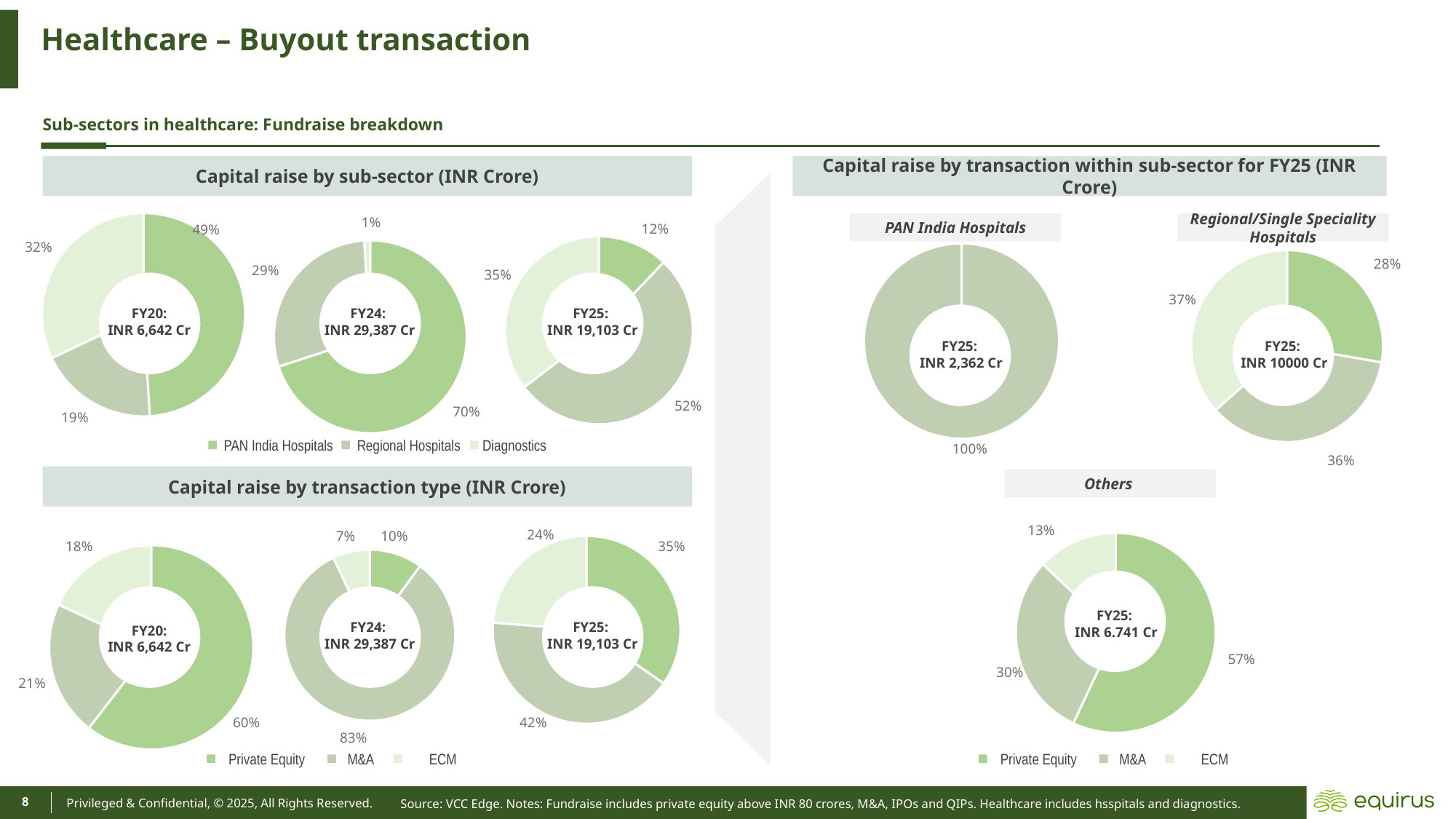
In the 'Capital raise by transaction type (INR Crore)' chart, what is the difference between the Private Equity share and the ECM share in FY20? 42% In the 'Capital raise by transaction within sub-sector for FY25 (INR Crore)' chart, what is the FY25 capital raise for Regional/Single Speciality Hospitals? INR 10000 Cr In the 'Capital raise by sub-sector (INR Crore)' chart, what is the total capital raise shown for FY24? INR 29,387 Cr In the 'Capital raise by transaction within sub-sector for FY25 (INR Crore)' chart, what share of the Others capital raise is Private Equity? 57% In the 'Capital raise by transaction type (INR Crore)' chart, which is larger in FY25: the Private Equity share or the M&A share? M&A In the 'Capital raise by sub-sector (INR Crore)' chart, what share of the FY20 capital raise is Diagnostics? 32% In the 'Capital raise by transaction type (INR Crore)' chart, what share of the FY24 capital raise is M&A? 83% In the 'Capital raise by sub-sector (INR Crore)' chart, which sub-sector has the smallest share in FY25? PAN India Hospitals In the 'Capital raise by sub-sector (INR Crore)' chart, which sub-sector has the largest share in FY24? PAN India Hospitals How many series does the legend of the 'Capital raise by transaction type (INR Crore)' chart list? 3 What type of chart is used in the 'Capital raise by sub-sector (INR Crore)' section? Donut (pie) chart